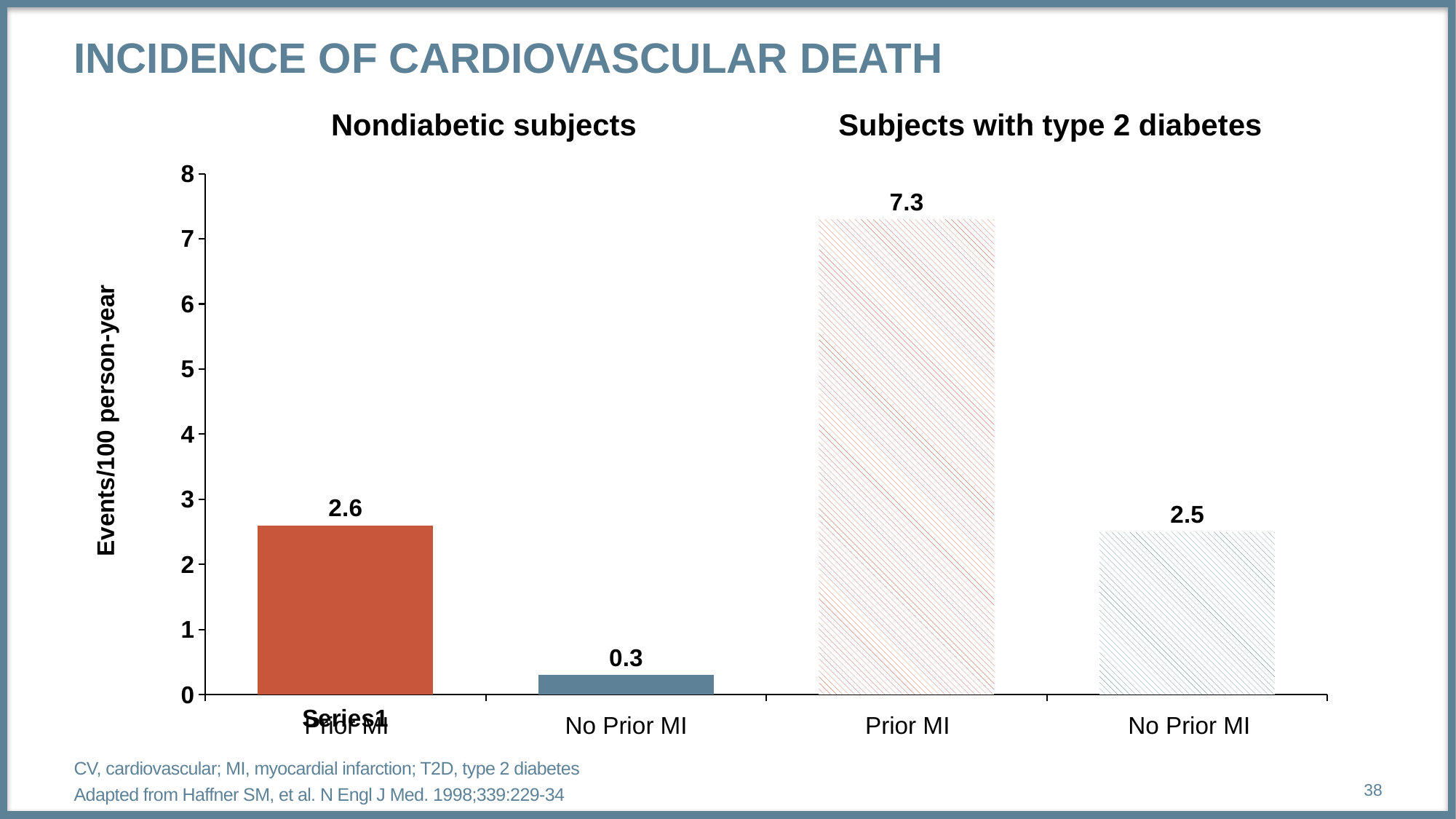
Which is larger: the No Prior MI value for subjects with type 2 diabetes or the Prior MI value for nondiabetic subjects? Prior MI value for nondiabetic subjects What type of chart is shown on the slide? Bar chart What is the difference between the Prior MI values for subjects with type 2 diabetes and nondiabetic subjects? 4.7 What is the value for No Prior MI among subjects with type 2 diabetes? 2.5 What is the label of the vertical axis? Events/100 person-year Which bar has the highest value on the chart? Prior MI, subjects with type 2 diabetes What is the value for Prior MI among nondiabetic subjects? 2.6 What is the difference between the Prior MI and No Prior MI values among nondiabetic subjects? 2.3 How many bars are plotted on the chart? 4 Which bar has the lowest value on the chart? No Prior MI, nondiabetic subjects What is the value for Prior MI among subjects with type 2 diabetes? 7.3 What is the value for No Prior MI among nondiabetic subjects? 0.3